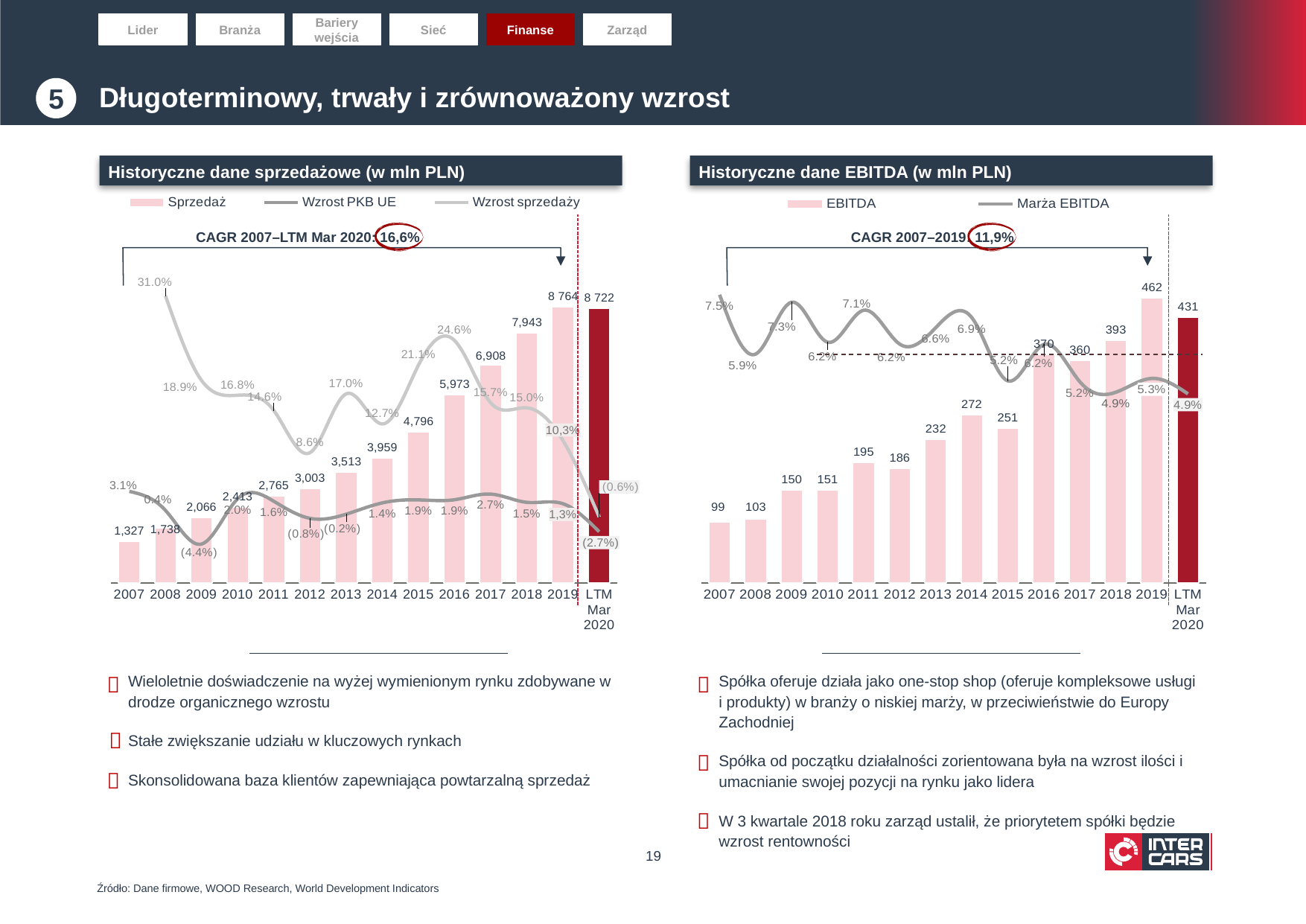
In the chart titled 'Historyczne dane EBITDA (w mln PLN)', what is the EBITDA value for 2014? 272 In the chart titled 'Historyczne dane EBITDA (w mln PLN)', what is the Marża EBITDA value for 2007? 7.5% In the chart titled 'Historyczne dane EBITDA (w mln PLN)', is the EBITDA value for 2019 larger than the value for LTM Mar 2020? Yes, 2019 (462) is larger than LTM Mar 2020 (431) In the chart titled 'Historyczne dane sprzedażowe (w mln PLN)', how many series does the legend list? 3 In the chart titled 'Historyczne dane sprzedażowe (w mln PLN)', what is the Sprzedaż value for 2015? 4,796 In the chart titled 'Historyczne dane sprzedażowe (w mln PLN)', what is the Wzrost PKB UE value for 2009? (4.4%) In the chart titled 'Historyczne dane sprzedażowe (w mln PLN)', what is the difference between the Sprzedaż values for 2018 and 2017? 1,035 In the chart titled 'Historyczne dane EBITDA (w mln PLN)', which year has the lowest EBITDA value? 2007 In the chart titled 'Historyczne dane sprzedażowe (w mln PLN)', what CAGR for 2007–LTM Mar 2020 is shown? 16,6% In the chart titled 'Historyczne dane sprzedażowe (w mln PLN)', which year has the highest Sprzedaż value? 2019 In the chart titled 'Historyczne dane EBITDA (w mln PLN)', how many periods are shown on the x axis? 14 In the chart titled 'Historyczne dane sprzedażowe (w mln PLN)', what is the Wzrost sprzedaży value for 2016? 24.6%